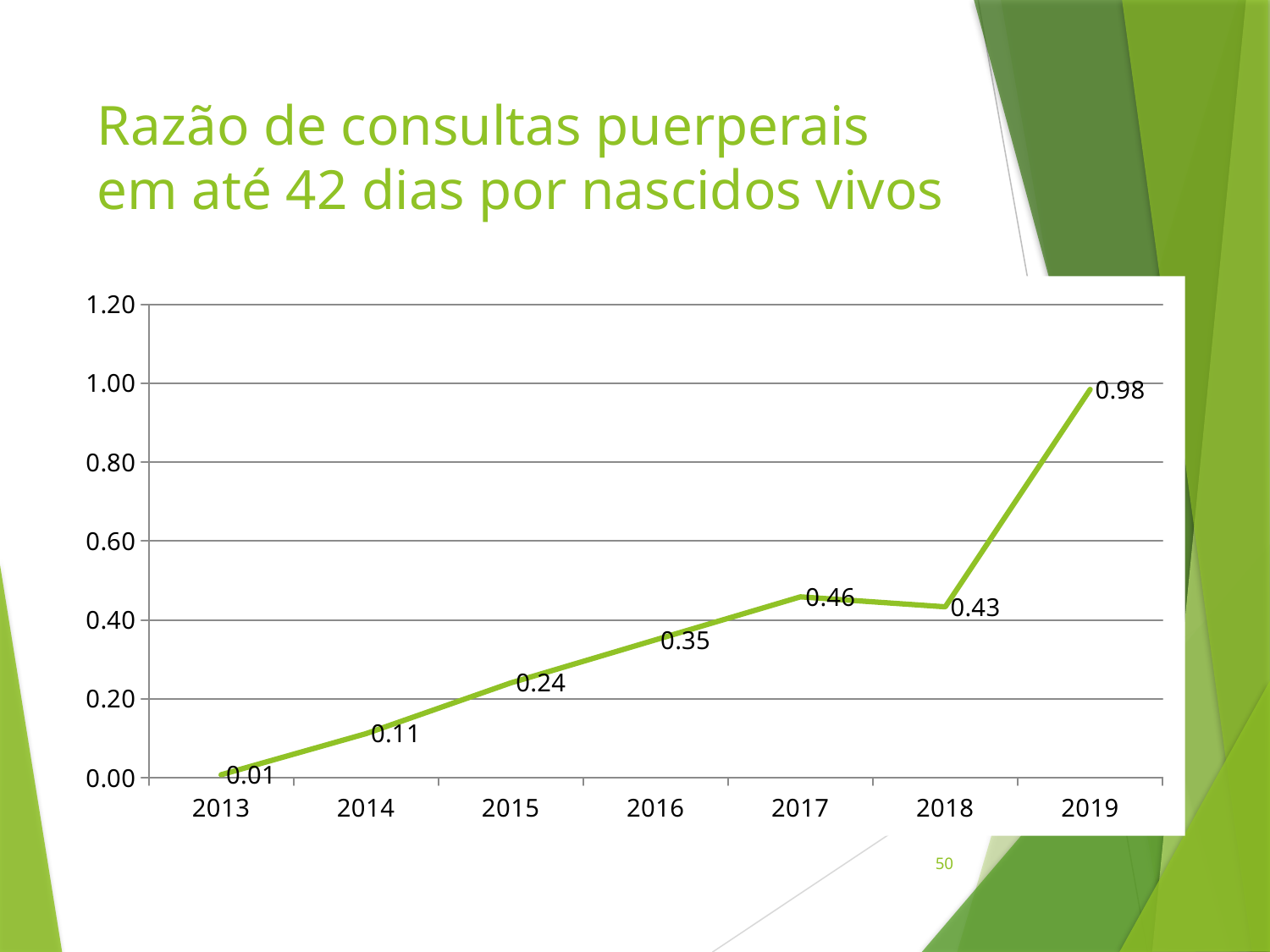
How many years are plotted on the chart? 7 What is the difference between the values for 2019 and 2018? 0.55 Does the value rise or fall from 2017 to 2018? fall What is the value for 2013? 0.01 What is the value for 2019? 0.98 What is the difference between the values for 2017 and 2016? 0.11 Which year has the lowest value? 2013 Which year has the highest value? 2019 What is the value for 2015? 0.24 Which is larger, the value for 2017 or the value for 2018? 2017 Is the value for 2016 greater or less than 0.40? less What kind of chart is shown on the slide? line chart